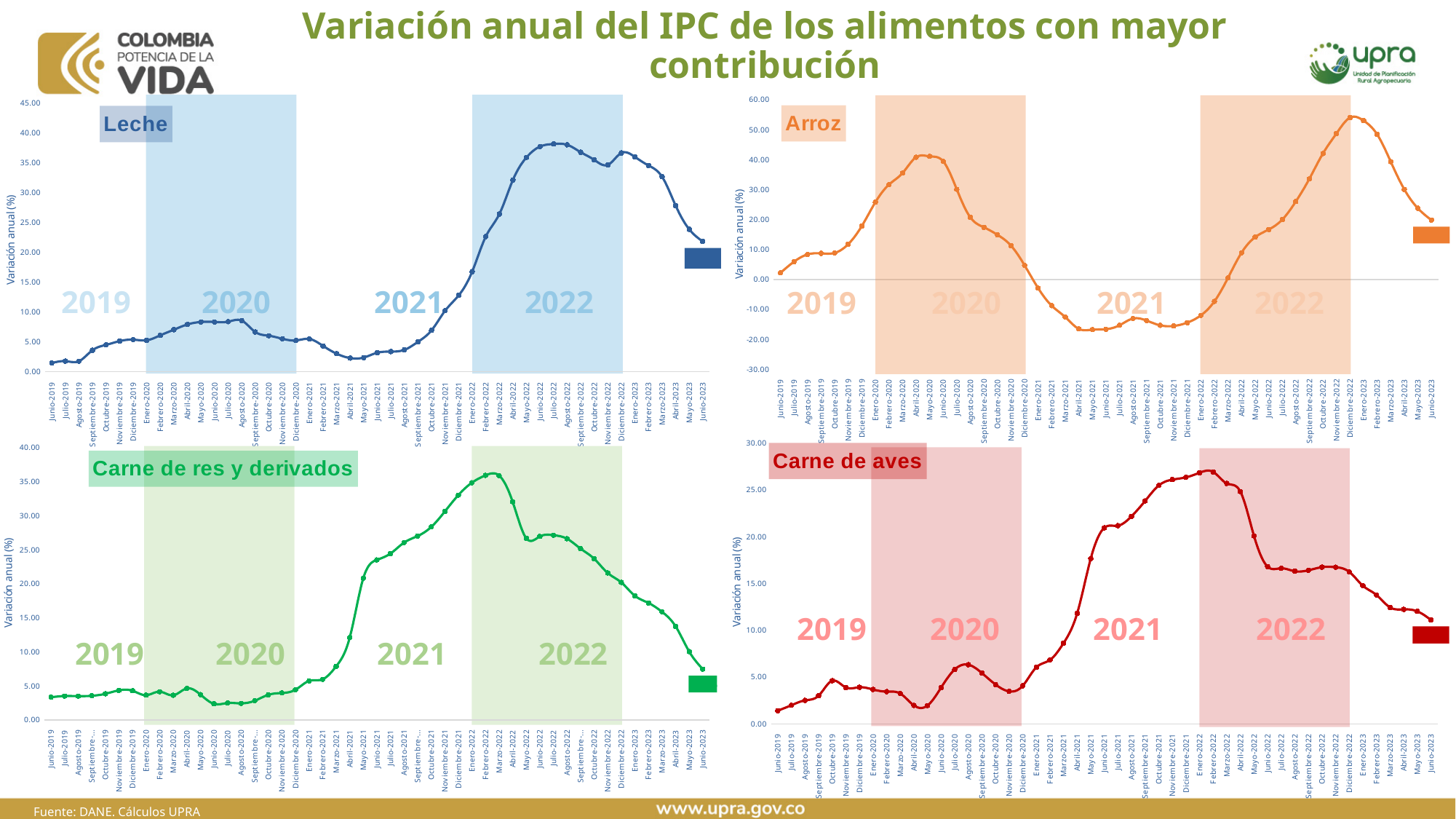
What is the title of the slide? Variación anual del IPC de los alimentos con mayor contribución In the Carne de res y derivados chart, is the value for Junio-2023 greater or less than 10.00? less In the Leche chart, do the values rise or fall from Enero-2023 to Junio-2023? fall What kind of chart is the Leche chart? line chart In the Arroz chart, is the value for Abril-2021 greater or less than -10.00? less In the Leche chart, is the value for Junio-2023 greater or less than 25.00? less How many charts are shown on the slide? 4 In the Arroz chart, do the values rise or fall from Junio-2019 to Abril-2020? rise